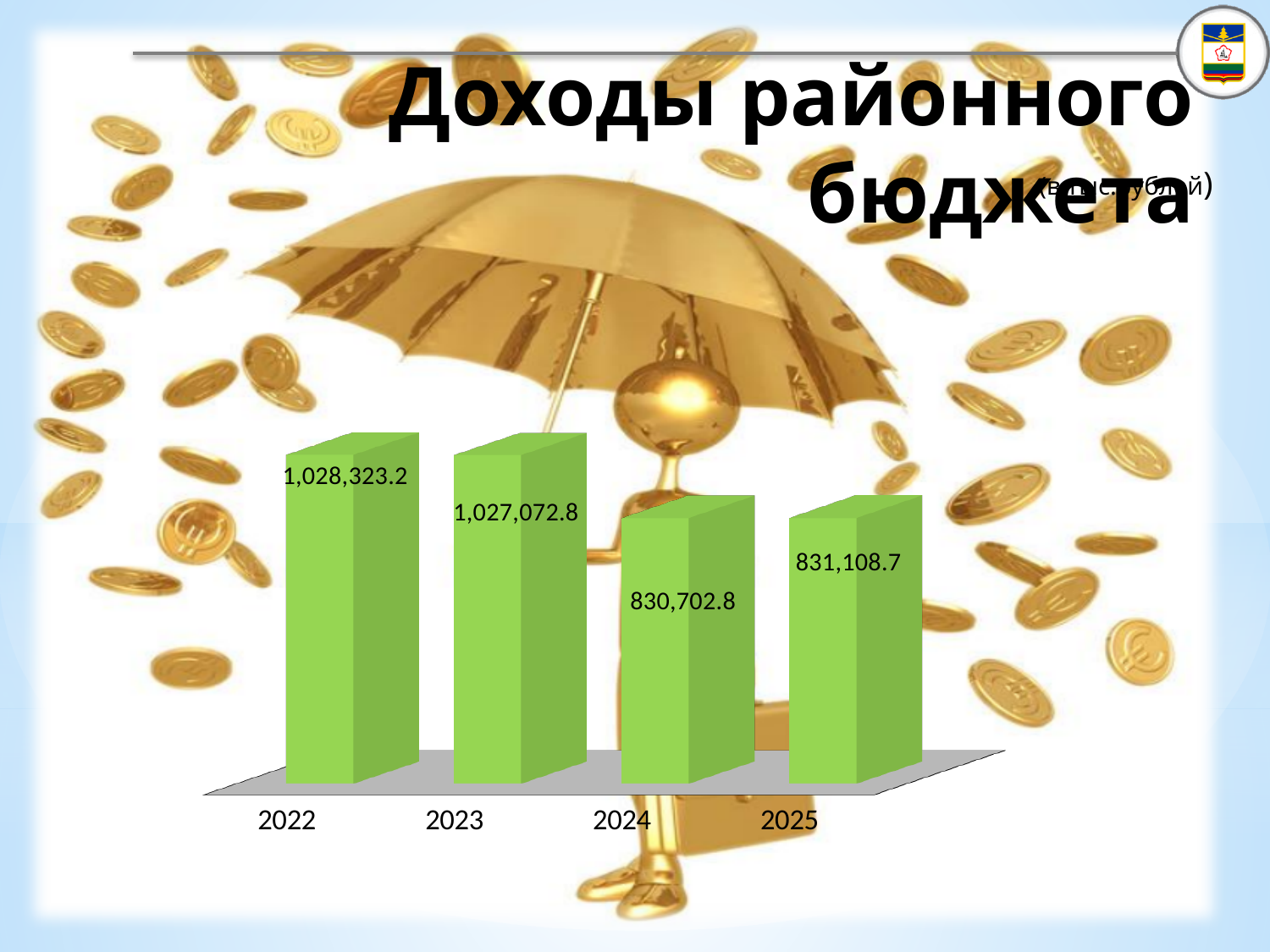
What is the value for 2023? 1,027,072.8 Do the values generally rise or fall from 2022 to 2025? Fall What is the value for 2025? 831,108.7 What is the difference between the values for 2022 and 2023? 1,250.4 What is the value for 2024? 830,702.8 Which is larger, the value for 2023 or the value for 2025? 2023 Which year has the highest value? 2022 Which year has the lowest value? 2024 What kind of chart is shown on the slide? Bar chart What is the value for 2022? 1,028,323.2 What is the difference between the values for 2025 and 2024? 405.9 How many years are shown on the chart? 4